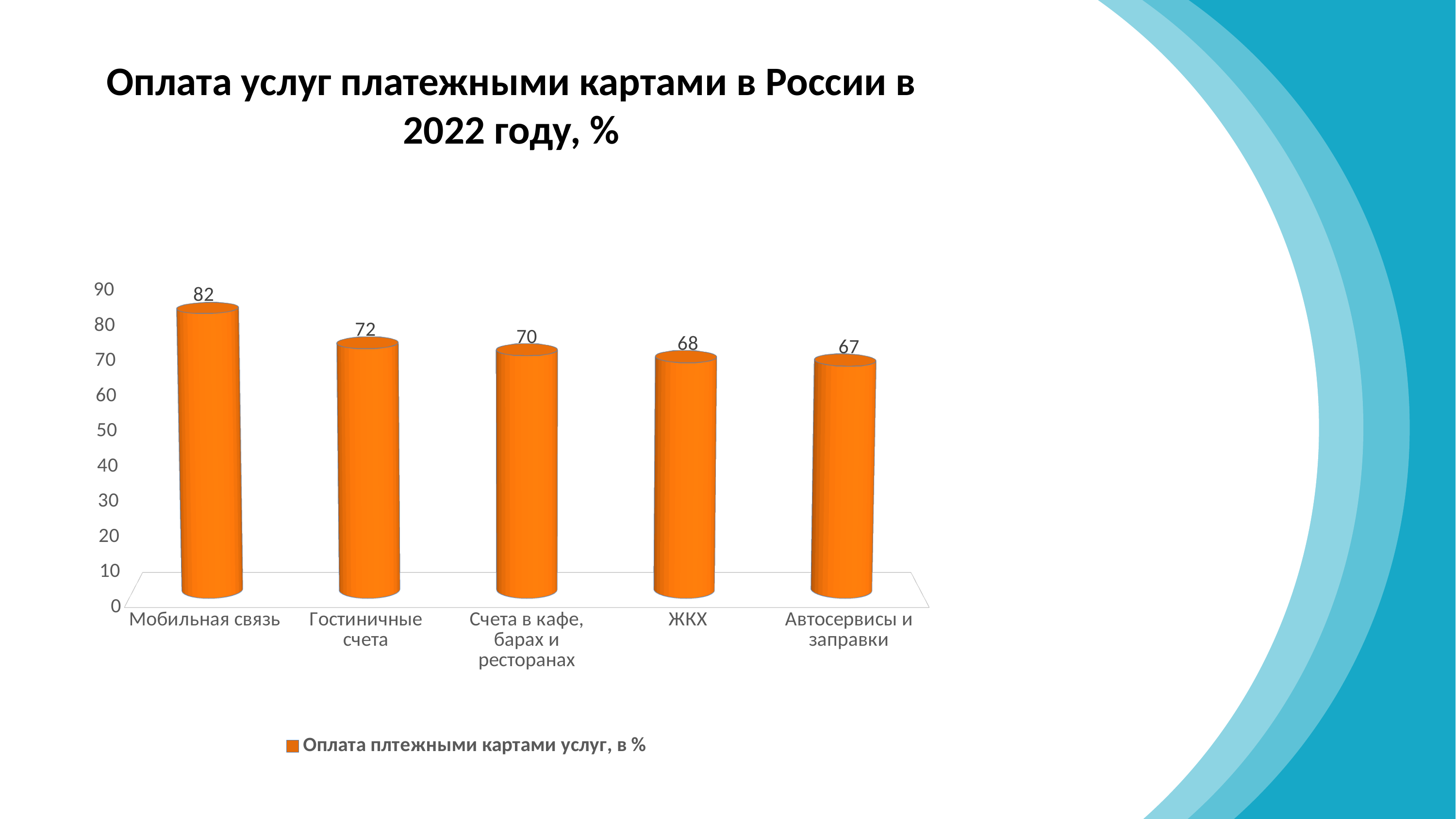
What kind of chart is shown on the slide? Bar chart What is the value for ЖКХ? 68 Which category has the highest value? Мобильная связь Which category has the lowest value? Автосервисы и заправки What is the difference between the values for Мобильная связь and Гостиничные счета? 10 How many series does the legend list? 1 Which is larger, the value for Счета в кафе, барах и ресторанах or the value for ЖКХ? Счета в кафе, барах и ресторанах What is the value for Гостиничные счета? 72 What is the value for Автосервисы и заправки? 67 Do the values rise or fall from left to right along the x axis? Fall How many categories are shown on the chart? 5 What is the value for Мобильная связь? 82